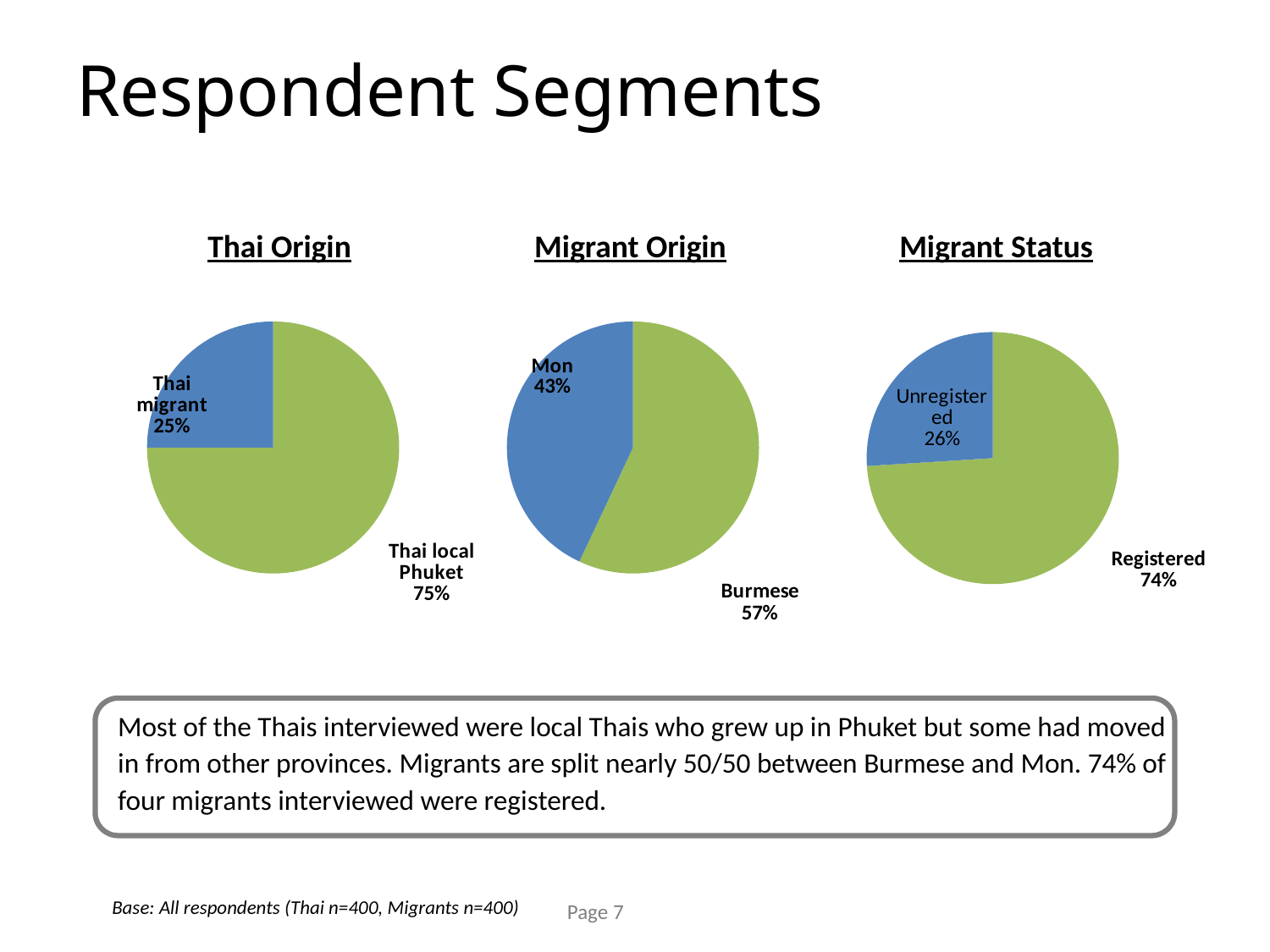
In the Migrant Origin pie chart, what is the difference in percentage points between the Burmese and Mon shares? 14 percentage points In the Migrant Origin pie chart, what share of respondents are Burmese? 57% In the Migrant Origin pie chart, which slice is larger, Burmese or Mon? Burmese In the Migrant Status pie chart, what share of respondents are Registered? 74% In the Migrant Status pie chart, which category has the smallest share? Unregistered What kind of chart is used for Migrant Status? Pie chart In the Thai Origin pie chart, what share of respondents are Thai migrant? 25% In the Thai Origin pie chart, which category has the largest share? Thai local Phuket How many slices does the Thai Origin pie chart have? 2